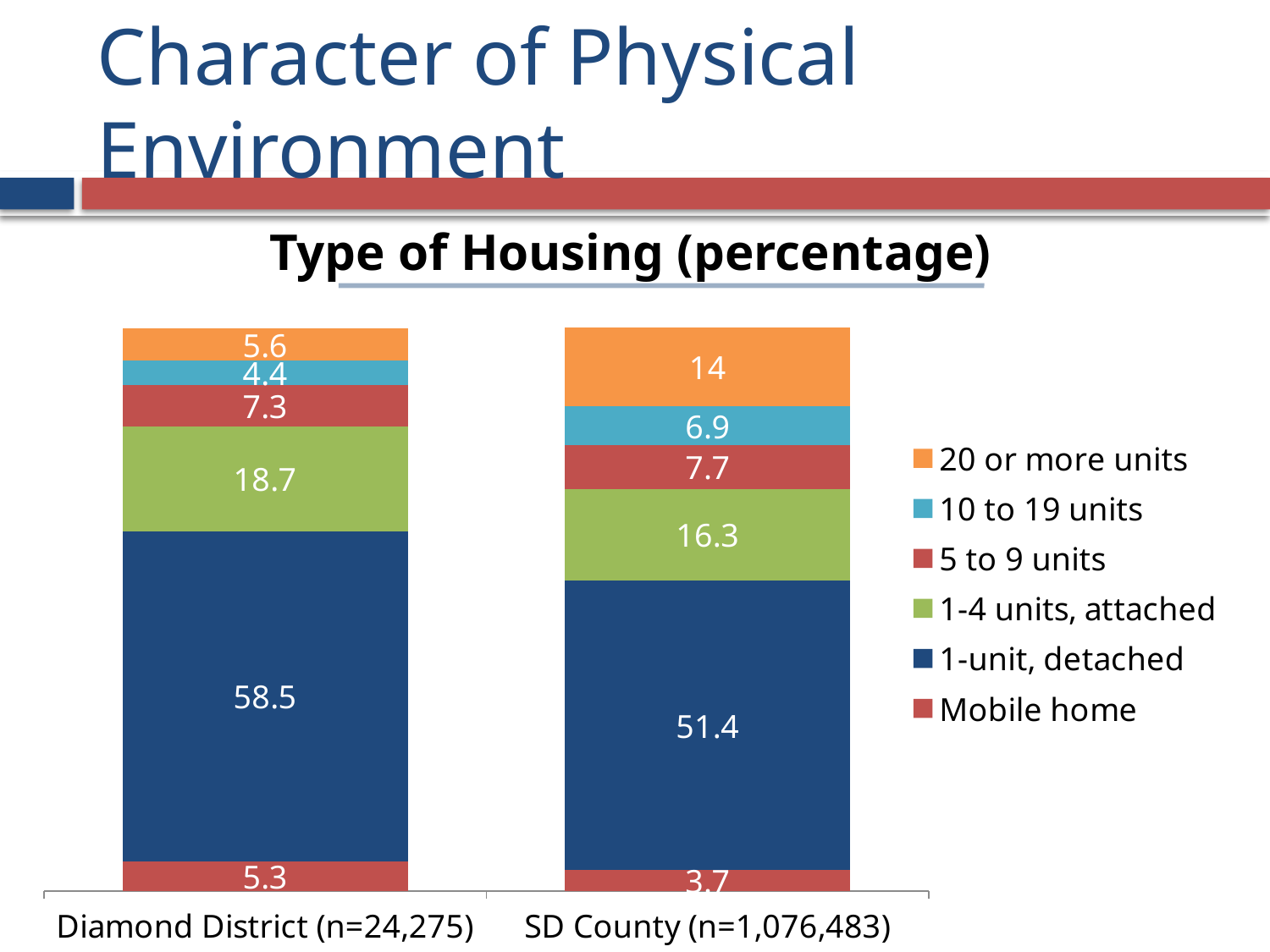
What is the value for 20 or more units in the SD County (n=1,076,483) bar? 14 How many bars (categories) are shown in the chart? 2 Which has a larger value for 20 or more units, Diamond District (n=24,275) or SD County (n=1,076,483)? SD County (n=1,076,483) What is the difference between the 1-unit, detached values for Diamond District (n=24,275) and SD County (n=1,076,483)? 7.1 What is the value for 1-unit, detached in the Diamond District (n=24,275) bar? 58.5 Which segment is the smallest in the SD County (n=1,076,483) bar? Mobile home How many series does the legend list? 6 What type of chart is shown on the slide? Stacked bar chart Which segment is the largest in the Diamond District (n=24,275) bar? 1-unit, detached What is the value for Mobile home in the SD County (n=1,076,483) bar? 3.7 What is the value for 1-4 units, attached in the Diamond District (n=24,275) bar? 18.7 What is the title of the chart? Type of Housing (percentage)